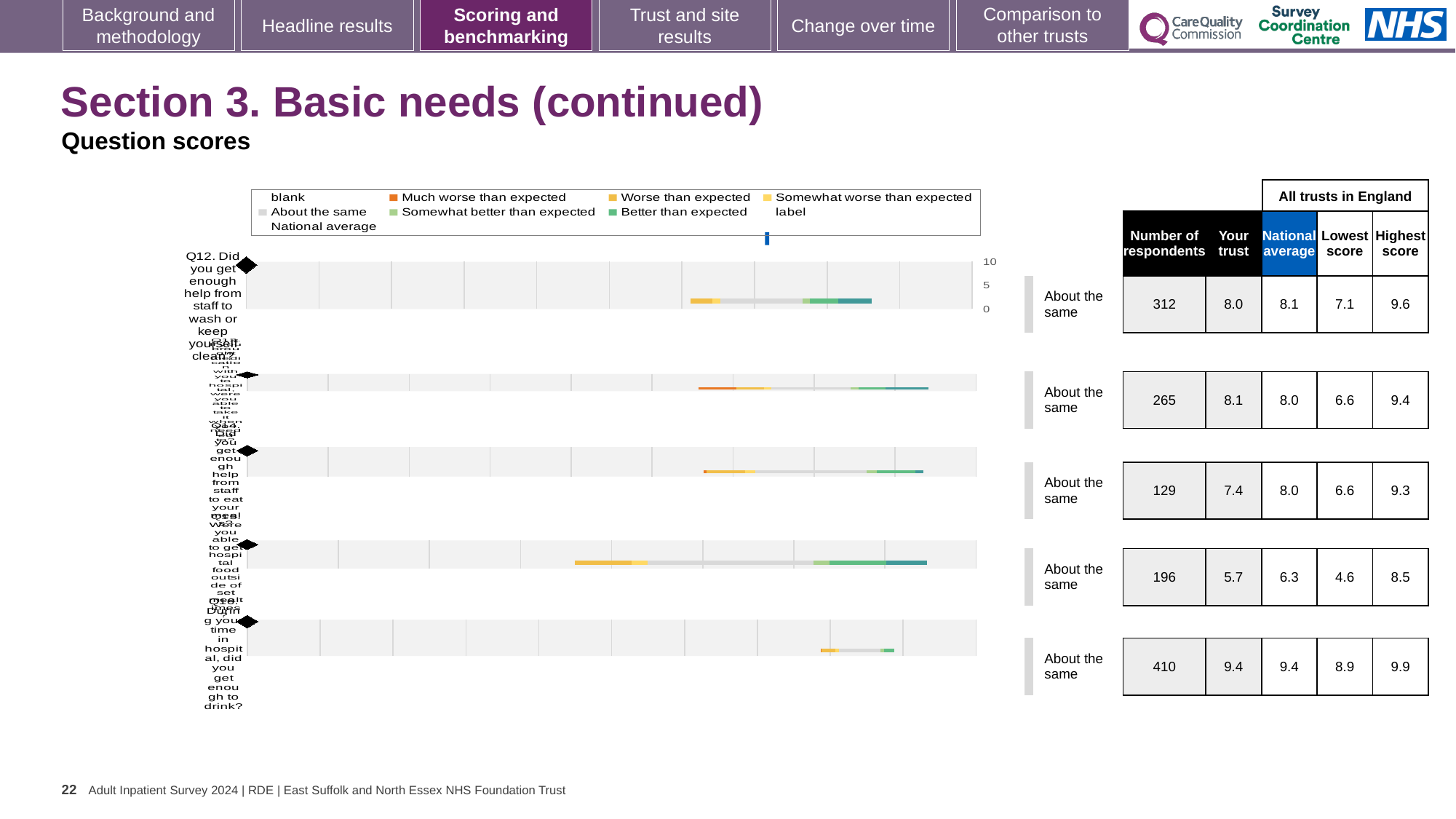
How many of the question rows are rated 'About the same'? 5 Which row has the lowest 'Your trust' score? the fourth row (Q15), 5.7 For the first row (Q12), what is the difference between the highest score and the lowest score across all trusts in England? 2.5 What benchmark rating is given to the fourth row (Q15)? About the same What is the number of respondents for Q12 (the first row, about getting enough help from staff to wash or keep yourself clean)? 312 How many question rows are plotted in the chart? 5 What is the national average for the first row (Q12)? 8.1 What kind of chart is used to show the question scores on this slide? bar chart Which row has the highest 'Your trust' score? the last row (Q16), 9.4 Which legend entry is shown in orange? Much worse than expected What is the 'Your trust' score for the first row (Q12)? 8.0 For the third row (Q14), which is larger: the 'Your trust' score or the national average? the national average (8.0)